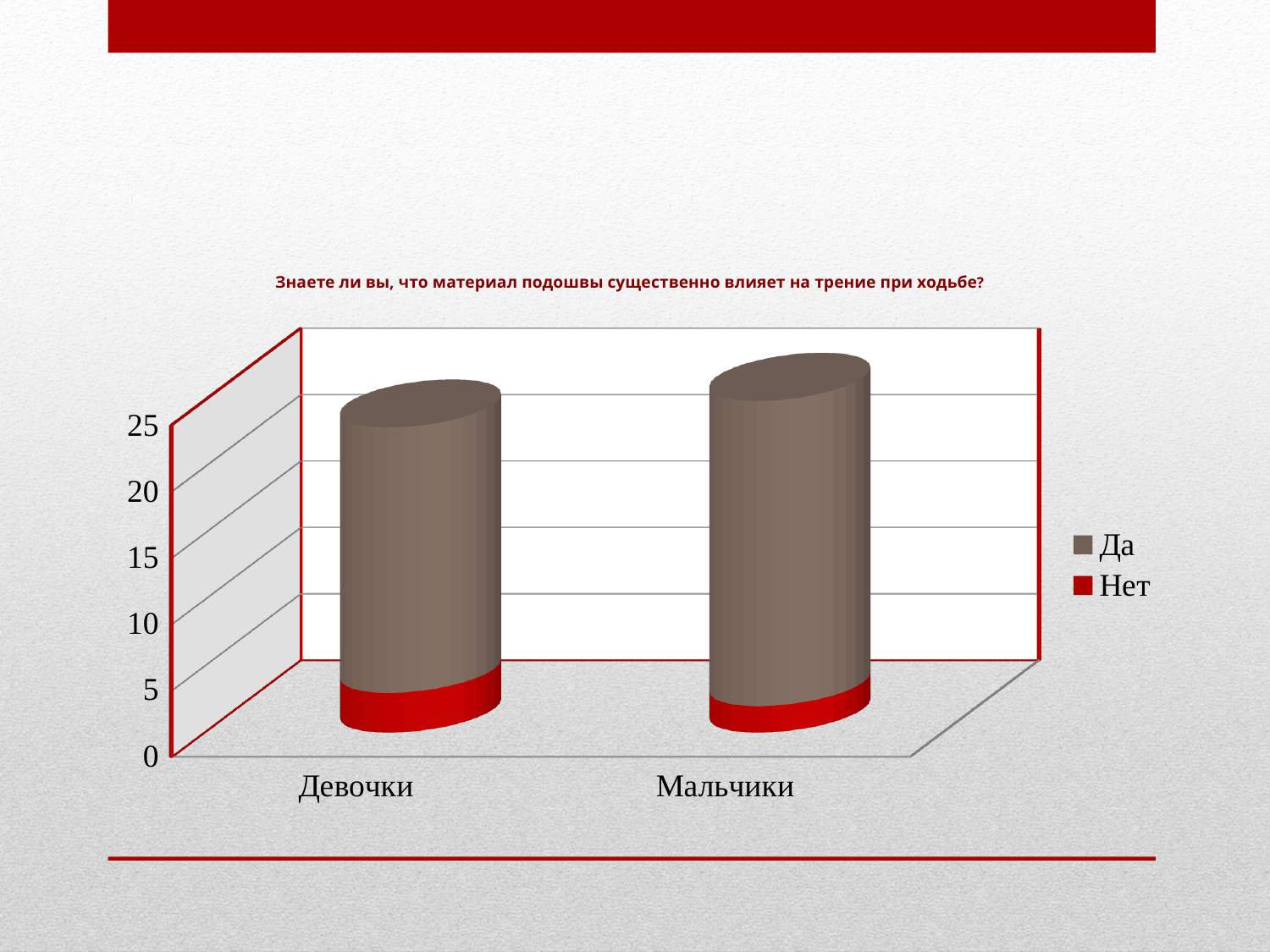
Which category has the taller stacked bar, Девочки or Мальчики? Мальчики For Девочки, which series is larger, Да or Нет? Да Is the total of the stacked bar for Девочки greater or less than 15? greater What are the two series listed in the chart's legend? Да and Нет What kind of chart is shown on the slide? bar chart Is the value of Нет for Мальчики greater or less than 10? less How many series does the chart's legend list? 2 Is the total of the stacked bar for Мальчики greater or less than 20? greater How many categories are shown on the x axis of the chart? 2 What is the title of the chart? Знаете ли вы, что материал подошвы существенно влияет на трение при ходьбе? For Мальчики, which series is larger, Да or Нет? Да